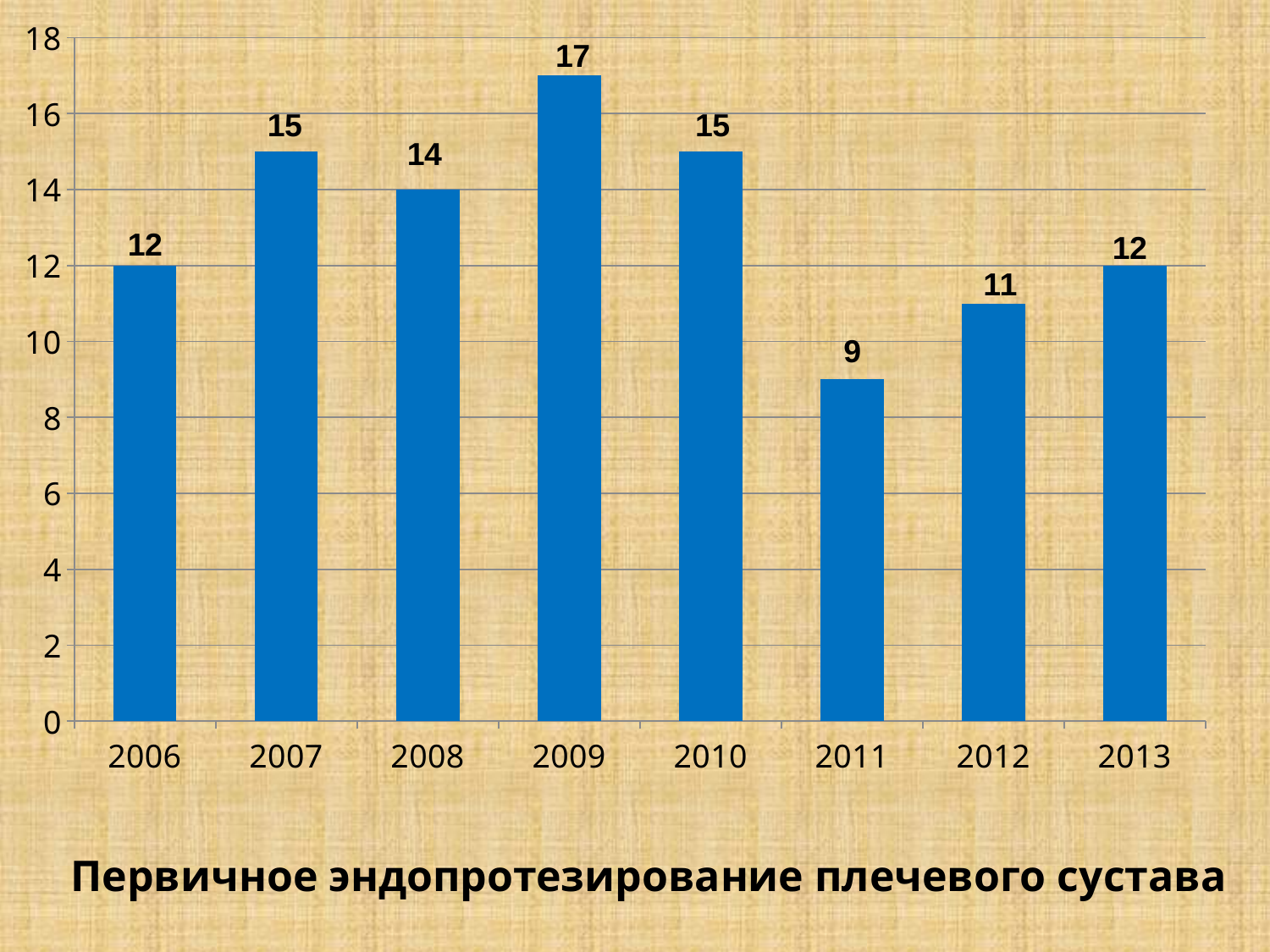
Which is larger, the value for 2008 or the value for 2012? 2008 Which year has the lowest value? 2011 What is the difference between the values for 2009 and 2011? 8 What is the value for 2013? 12 What is the value for 2011? 9 Which year has the highest value? 2009 What kind of chart is shown on the slide? bar chart What is the value for 2009? 17 What is the title text shown below the chart? Первичное эндопротезирование плечевого сустава How many years are shown on the x axis? 8 Is the value for 2010 greater or less than 14? greater What is the difference between the values for 2007 and 2012? 4